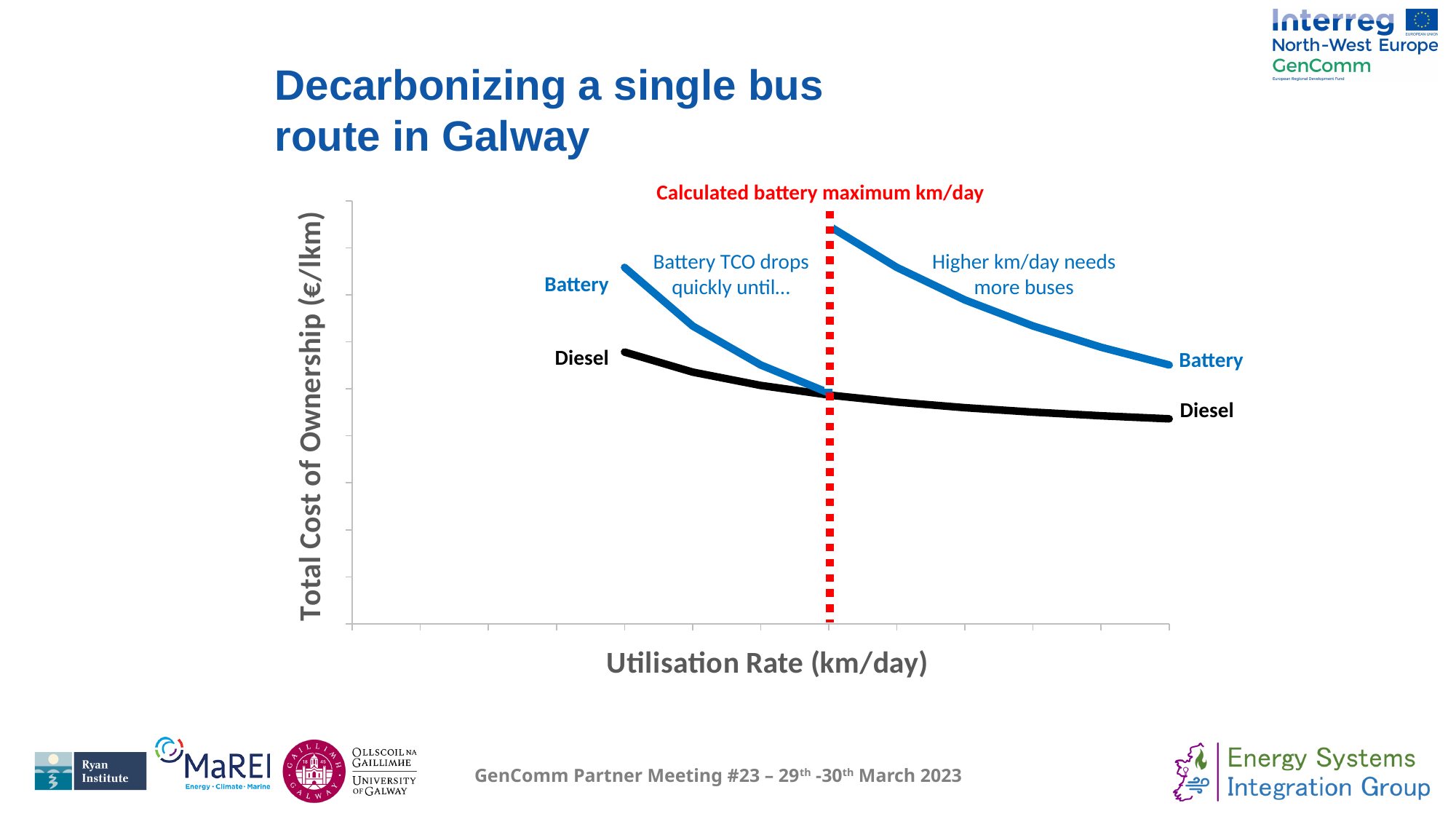
What is the title of the x axis? Utilisation Rate (km/day) What kind of chart is shown on the slide? line chart What is the title of the y axis? Total Cost of Ownership (€/lkm) At the right end of the chart, which series has the lower total cost of ownership, Battery or Diesel? Diesel Does the Battery line rise or fall as the utilisation rate increases? fall Does the Diesel line rise or fall as the utilisation rate increases? fall Which series is drawn in black? Diesel At the left end of the chart, which series has the higher total cost of ownership, Battery or Diesel? Battery How many data series are plotted on the chart? 2